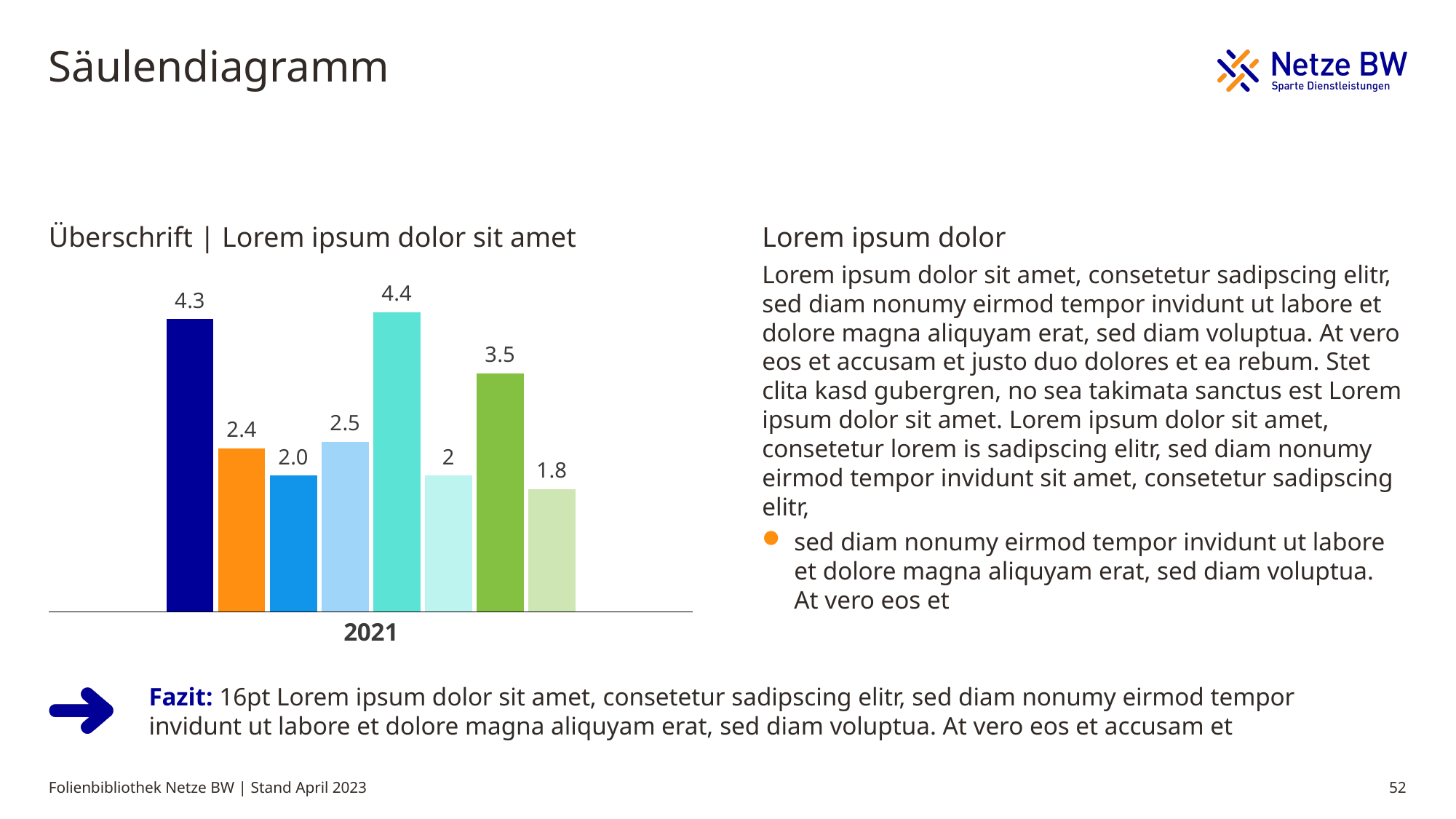
How many bars are plotted in the chart? 8 What is the lowest value shown in the chart? 1.8 What is the value of the first (dark blue) bar from the left? 4.3 What is the value of the green bar? 3.5 What kind of chart is shown on the slide? bar chart What is the value of the last (rightmost) bar? 1.8 What is the value of the orange bar? 2.4 What is the highest value shown in the chart? 4.4 What is the title of the chart? Überschrift | Lorem ipsum dolor sit amet Which is larger, the orange bar or the green bar? the green bar What is the difference between the highest bar (4.4) and the lowest bar (1.8)? 2.6 What is the only category label shown on the x axis? 2021